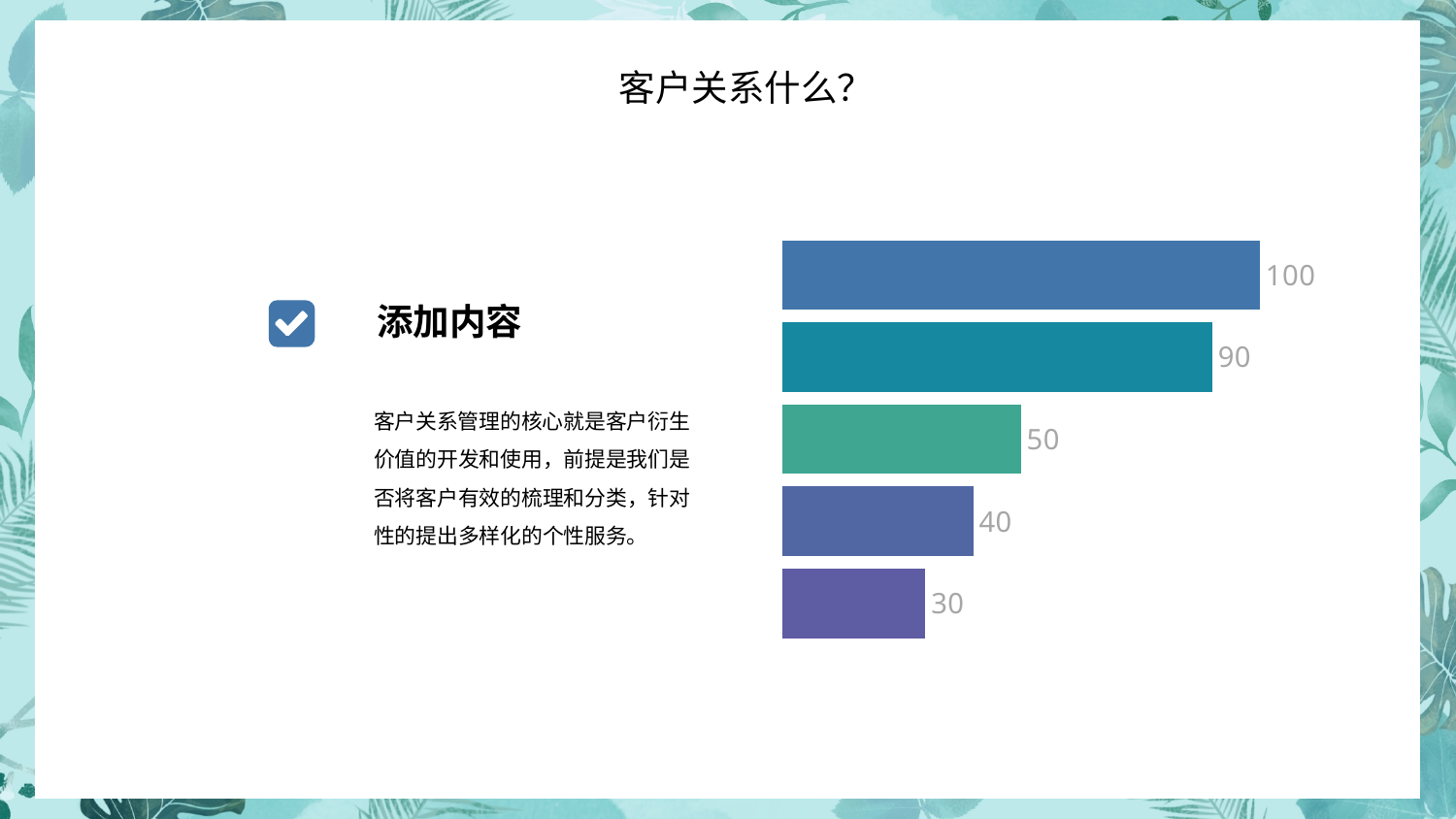
What is the value of the middle (third) bar? 50 Do the bar values increase or decrease from the top bar to the bottom bar? decrease What kind of chart is shown on the right side of the slide? bar chart What is the value of the bottom bar in the chart? 30 What is the highest value shown in the chart? 100 What is the lowest value shown in the chart? 30 What is the value of the top bar in the chart? 100 What is the value of the fourth bar from the top? 40 What is the difference between the top bar and the bottom bar? 70 How many bars does the chart contain? 5 Which is larger, the second bar from the top or the third bar from the top? the second bar (90) What is the value of the second bar from the top? 90